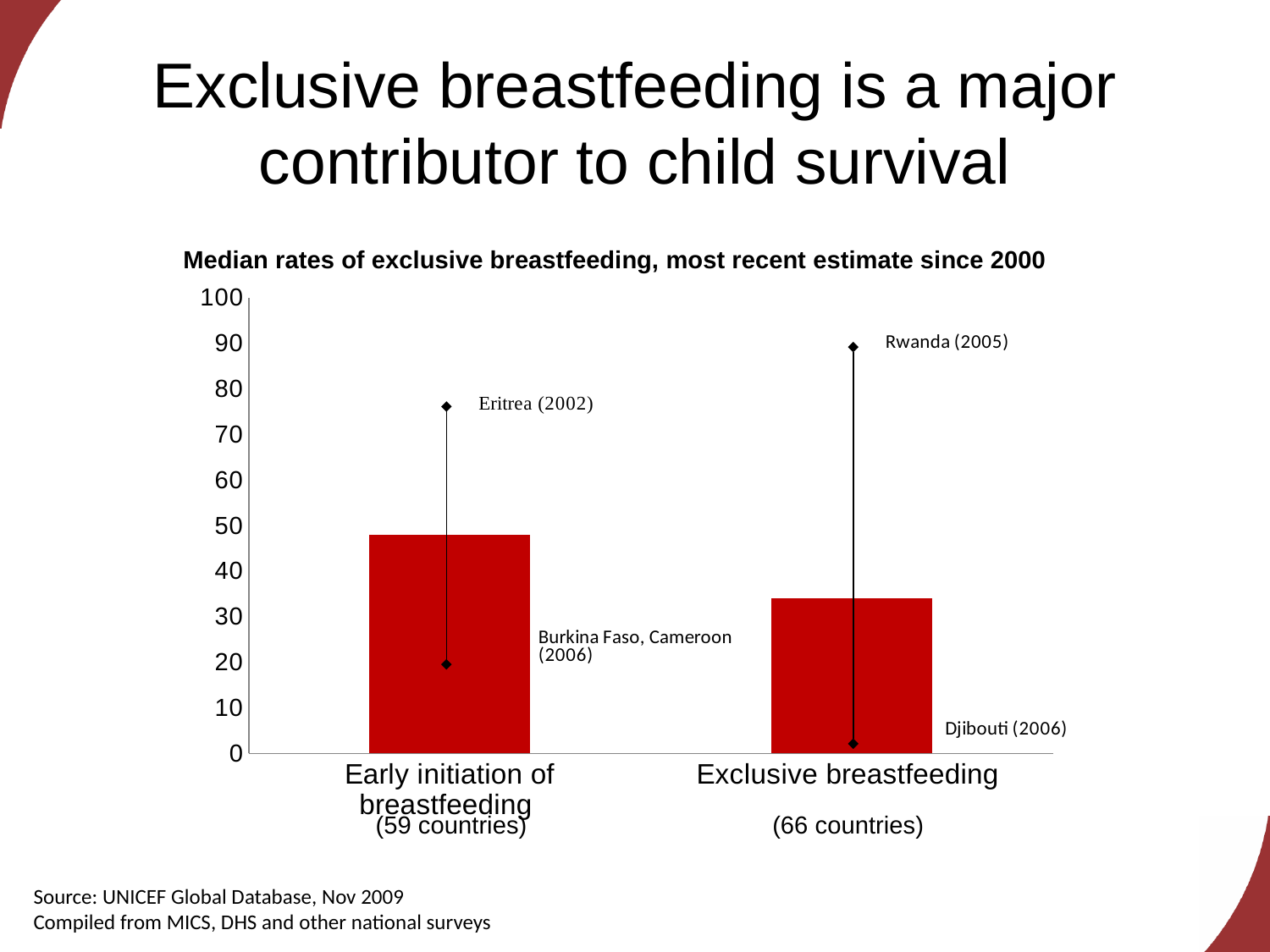
Is the median value for Early initiation of breastfeeding greater or less than 40? greater What kind of chart is shown on the slide? bar chart How many countries are included in the Exclusive breastfeeding category, according to the axis label? 66 countries How many bars (categories) are plotted in the chart? 2 Is the bar for Early initiation of breastfeeding taller or shorter than the bar for Exclusive breastfeeding? taller Is the median value for Exclusive breastfeeding greater or less than 30? greater Is the point labelled Djibouti (2006) greater or less than 10? less Which category has the lower median rate? Exclusive breastfeeding What is the title of the chart? Median rates of exclusive breastfeeding, most recent estimate since 2000 Which category has the higher median rate, Early initiation of breastfeeding or Exclusive breastfeeding? Early initiation of breastfeeding